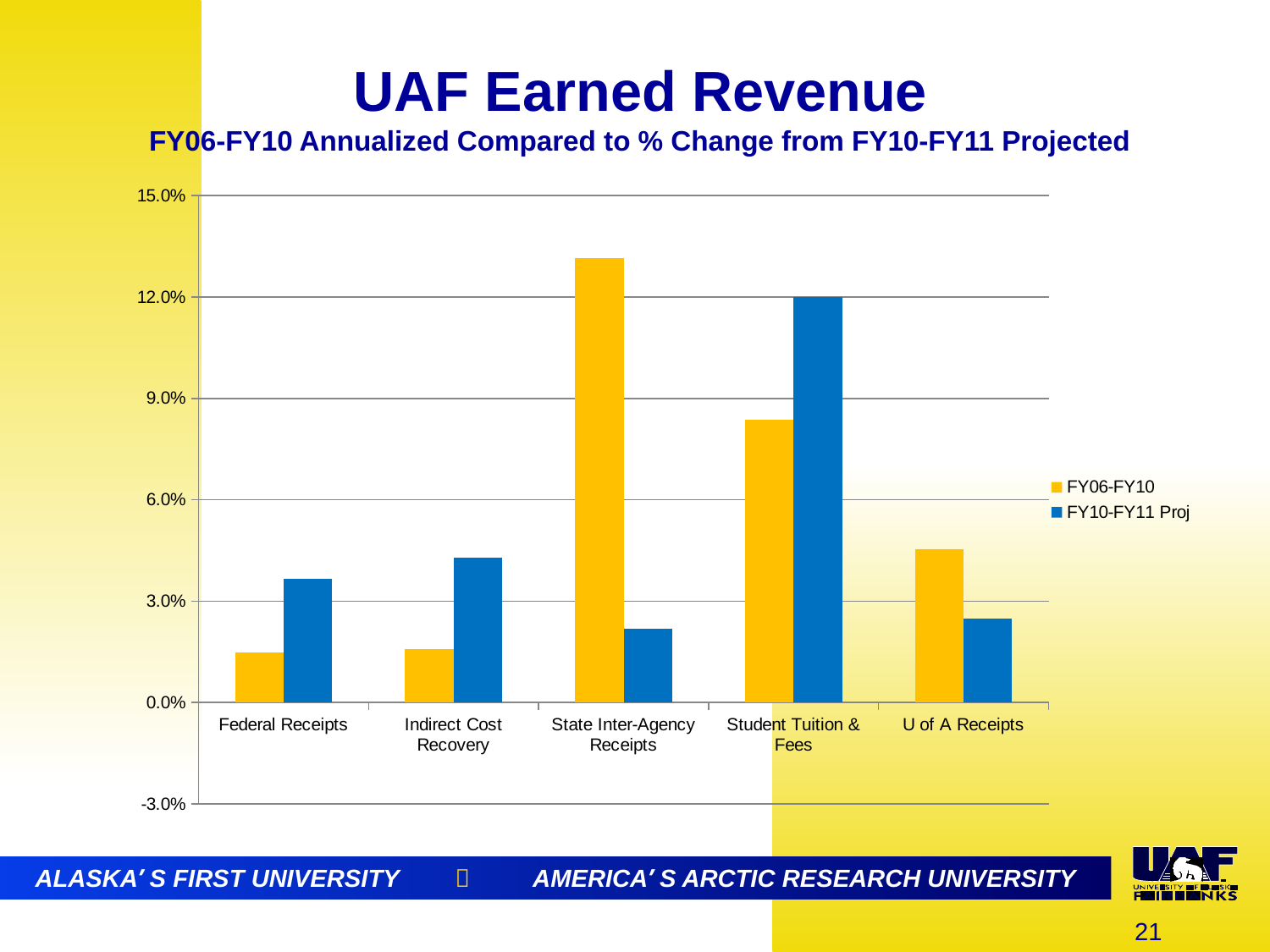
How many series does the chart's legend list? 2 What kind of chart is shown on the slide? Bar chart Is the FY06-FY10 value for Student Tuition & Fees greater or less than 9.0%? less Which category has the highest FY06-FY10 value? State Inter-Agency Receipts How many categories are shown on the x axis of the chart? 5 Is the FY10-FY11 Proj value for Federal Receipts greater or less than 3.0%? greater For State Inter-Agency Receipts, which is larger: the FY06-FY10 value or the FY10-FY11 Proj value? FY06-FY10 Which category has the highest FY10-FY11 Proj value? Student Tuition & Fees Is the FY06-FY10 value for State Inter-Agency Receipts greater or less than 12.0%? greater For Federal Receipts, which is larger: the FY06-FY10 value or the FY10-FY11 Proj value? FY10-FY11 Proj Which colour represents the FY10-FY11 Proj series in the chart? Blue